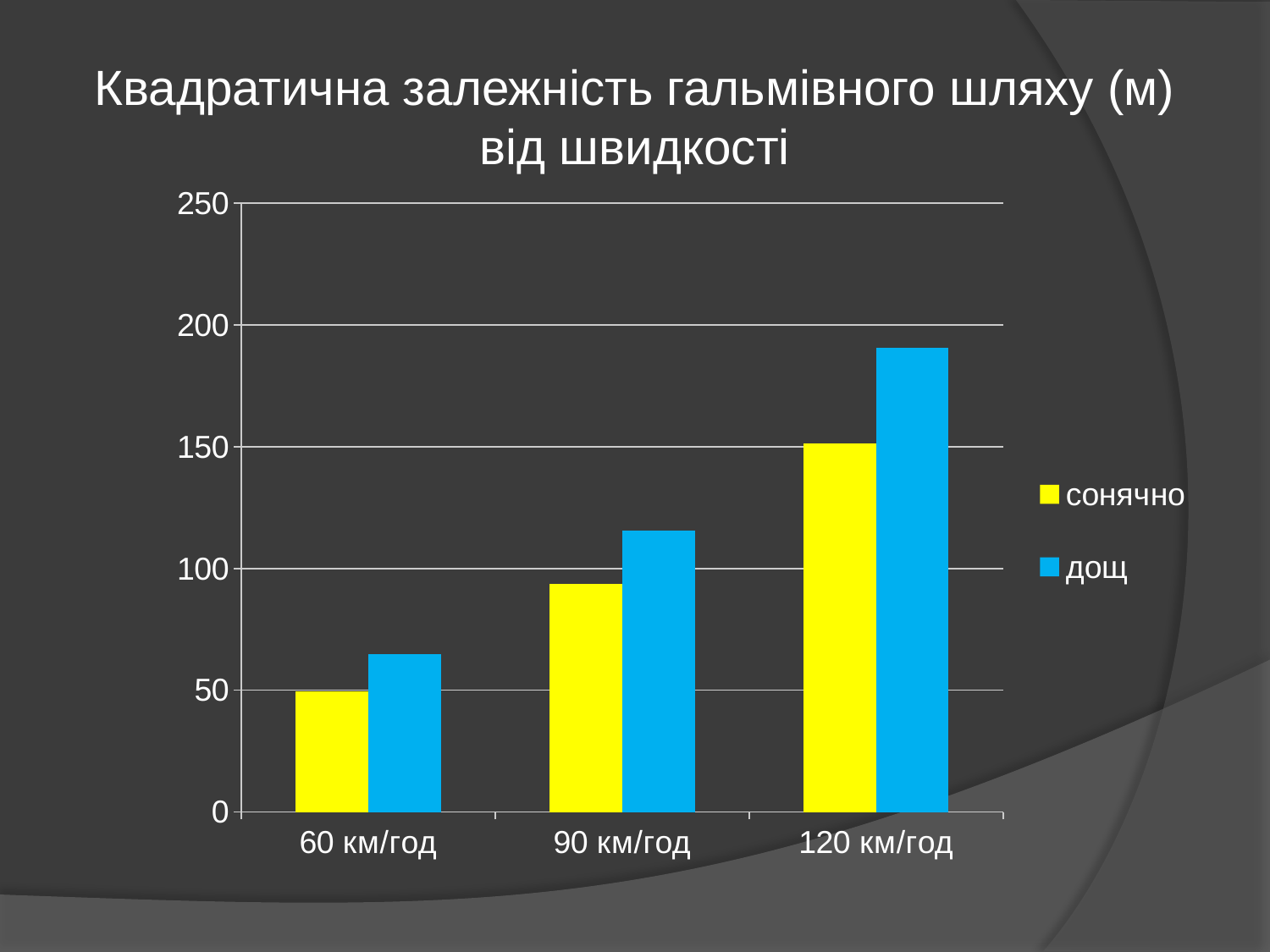
Is the value for дощ at 60 км/год greater or less than 50? greater Which colour represents the дощ series in the legend? blue Is the value for дощ at 120 км/год greater or less than 200? less How many series does the legend list? 2 How many speed categories are shown on the x axis? 3 At 90 км/год, which series has the larger value, сонячно or дощ? дощ Which speed category has the lowest value for сонячно? 60 км/год Is the value for дощ at 90 км/год greater or less than 100? greater What kind of chart is shown on the slide? bar chart Which speed category has the highest value for дощ? 120 км/год Do the values for сонячно rise or fall as speed increases along the x axis? rise